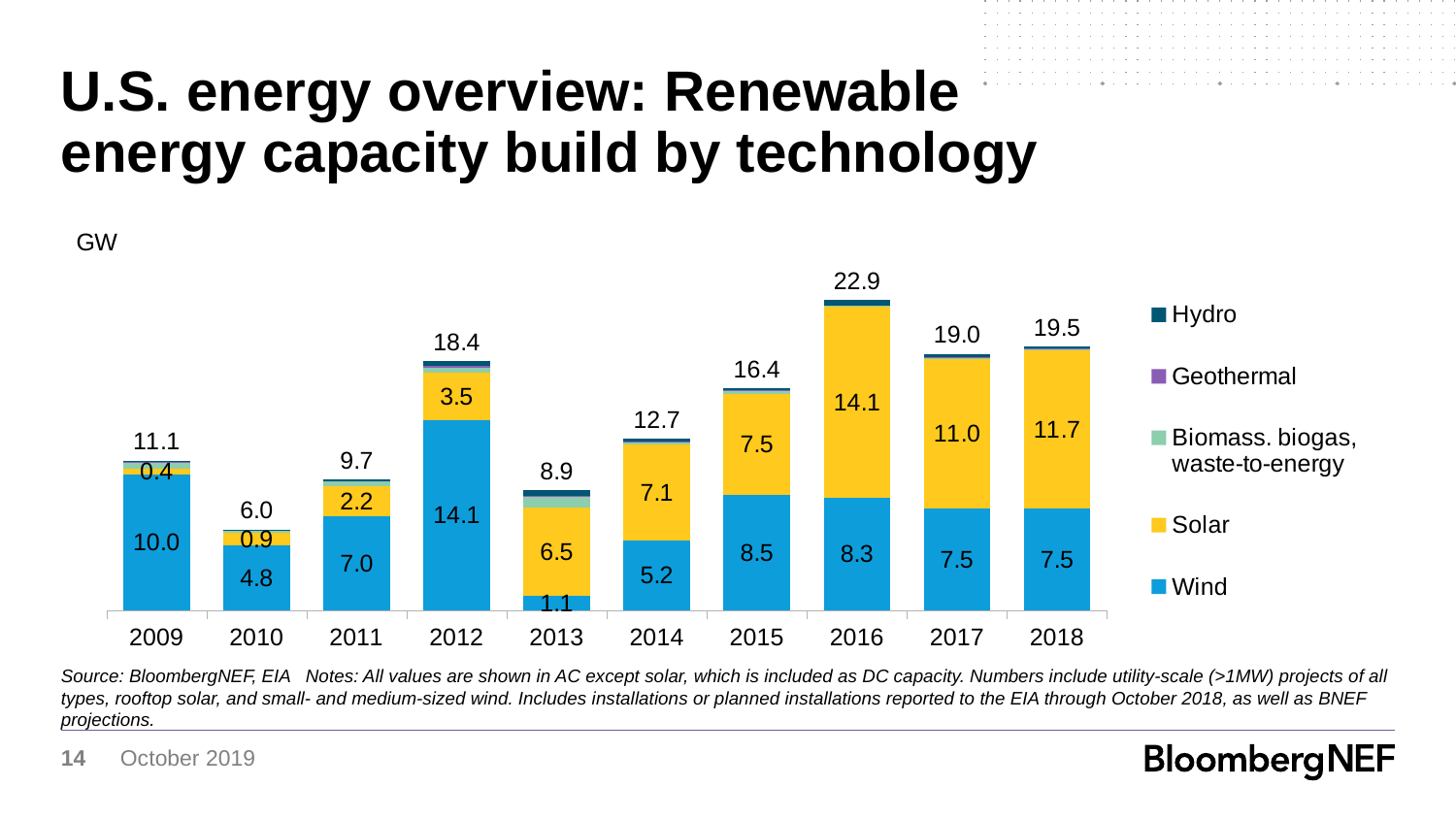
What is the Wind value for 2012? 14.1 Which year has the lowest total capacity build? 2010 Which year has the lowest Wind value? 2013 What is the Solar value for 2018? 11.7 How many series does the legend list? 5 Is the Solar value larger in 2015 or in 2016? 2016 Which year has the highest total capacity build? 2016 What kind of chart is shown on the slide? Stacked bar chart What unit is shown above the chart? GW What is the total renewable capacity build shown for 2016? 22.9 How many years are shown on the x axis? 10 What is the difference between the total for 2016 and the total for 2017? 3.9